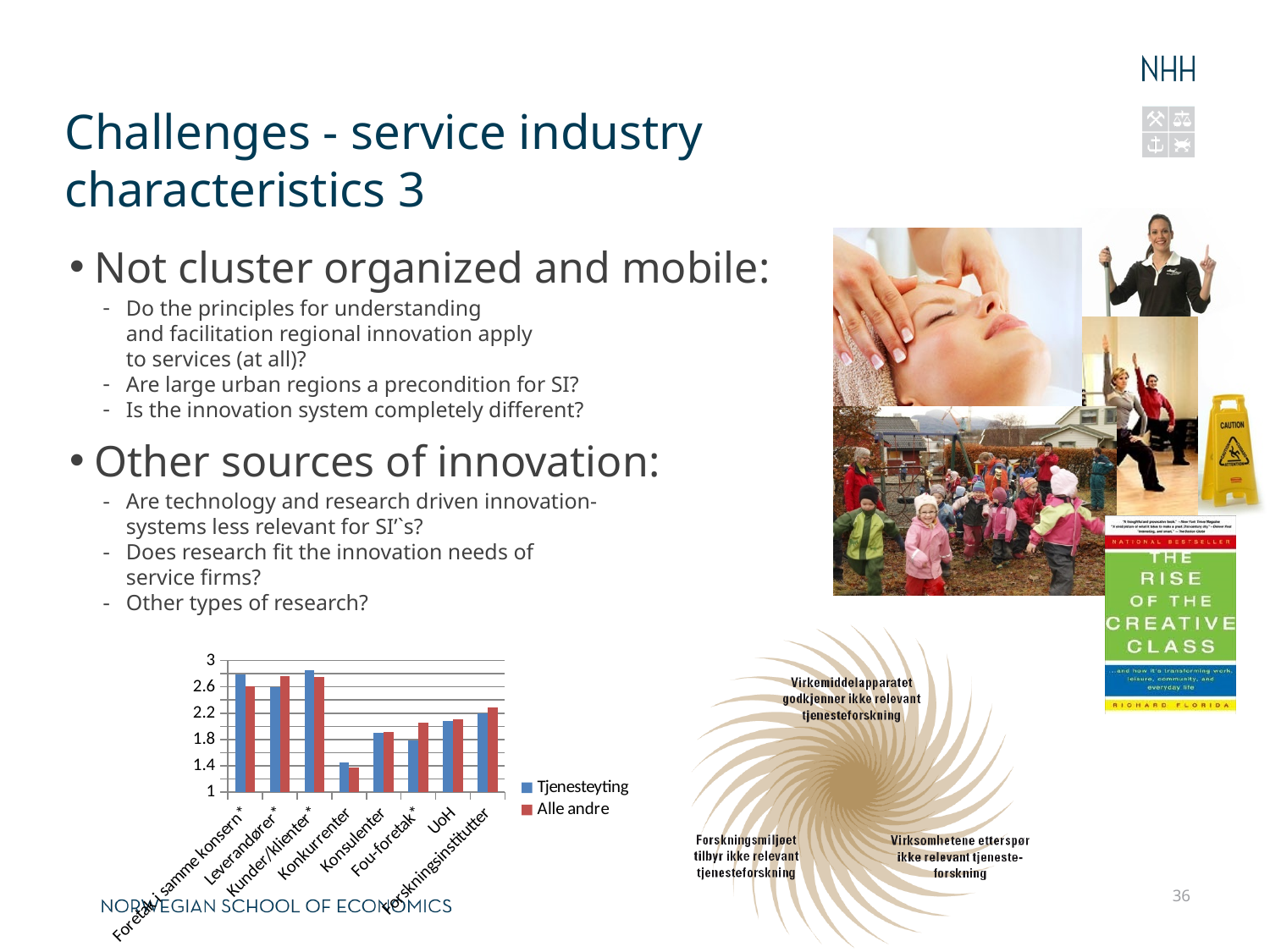
Is the Alle andre value for Fou-foretak * greater or less than 1.8? greater Which series in the bar chart is shown in red? Alle andre Is the Tjenesteyting value for Konkurrenter greater or less than 1.8? less How many series does the legend of the bar chart list? 2 Is the Alle andre value for Konsulenter greater or less than 2.2? less Which category has the lowest value for the Tjenesteyting series in the bar chart? Konkurrenter How many categories are shown on the x axis of the bar chart? 8 For Foretak i samme konsern *, which series has the larger value, Tjenesteyting or Alle andre? Tjenesteyting What kind of chart is shown at the bottom left of the slide? bar chart For Fou-foretak *, which series has the larger value, Tjenesteyting or Alle andre? Alle andre Which category has the lowest value for the Alle andre series in the bar chart? Konkurrenter